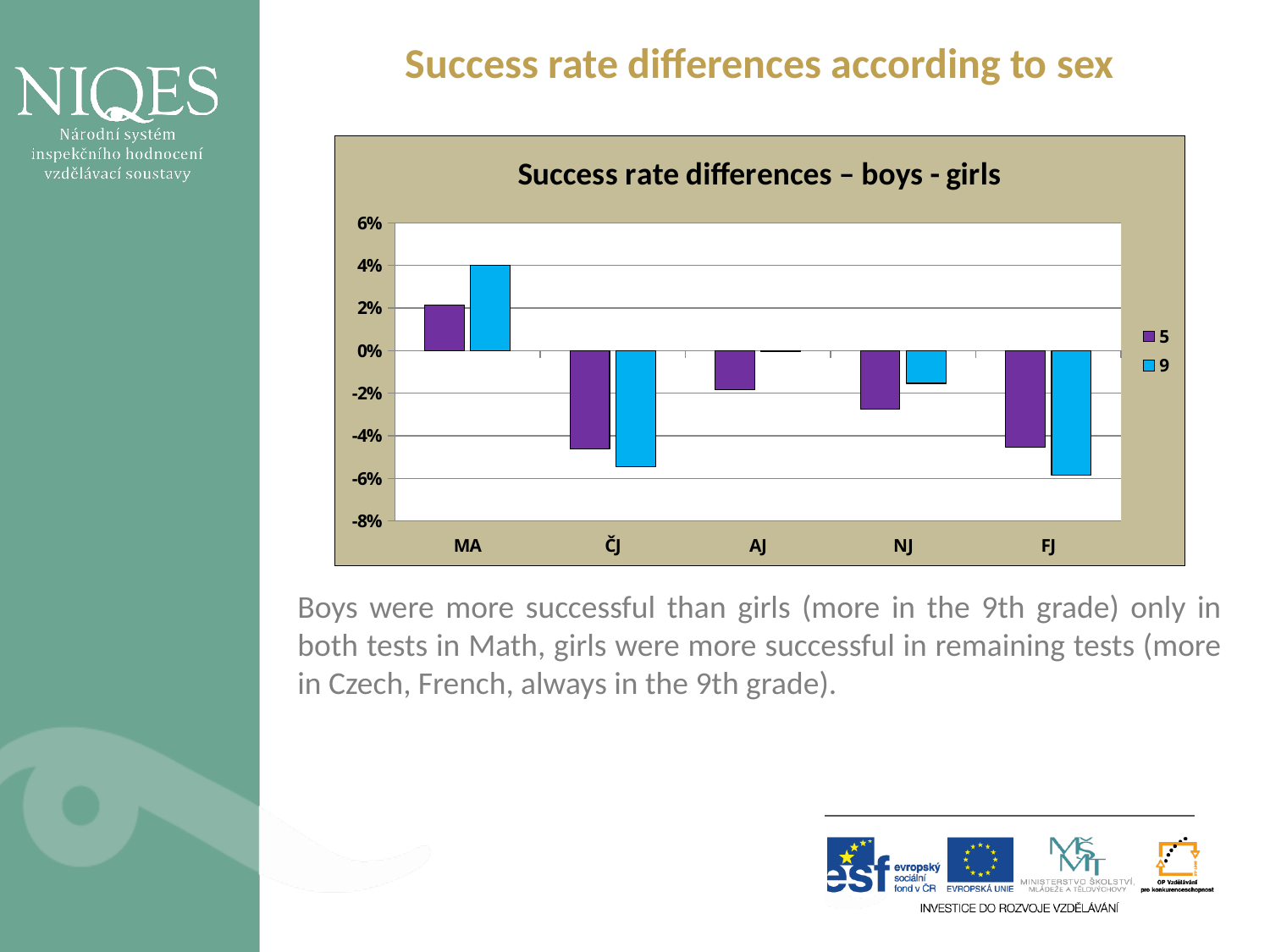
What kind of chart is shown on the slide? bar chart How many series does the legend list? 2 Which category has the highest value for series 5? MA Is the value for NJ in series 5 greater or less than -2%? less What is the title of the chart? Success rate differences – boys - girls For NJ, which series has the larger value, 5 or 9? 9 For MA, which series has the larger value, 5 or 9? 9 Is the value for ČJ in series 5 greater or less than -4%? less Which category has the highest value for series 9? MA Which colour represents series 9 in the chart? blue Is the value for MA in series 9 greater or less than 2%? greater How many categories are shown on the x axis? 5